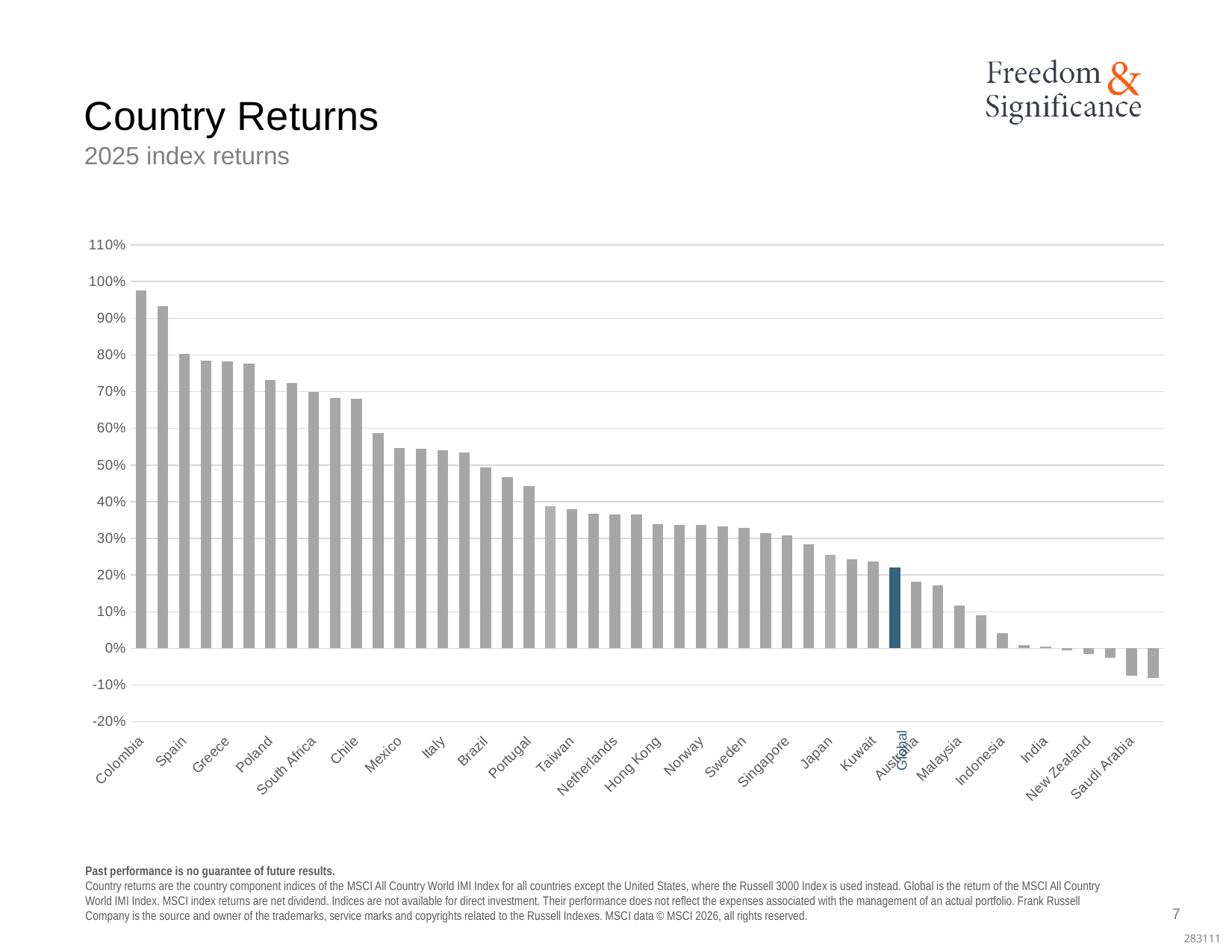
Which has the larger value, Greece or Chile? Greece Do the bar values rise or fall moving from left to right along the x axis? fall Is the value for Japan greater or less than 30%? less Is the value for Mexico greater or less than 60%? less What kind of chart is shown on the slide? bar chart Is the value for Portugal greater or less than 40%? greater Which country has the highest 2025 index return in the chart? Colombia What is the subtitle shown under the chart title 'Country Returns'? 2025 index returns